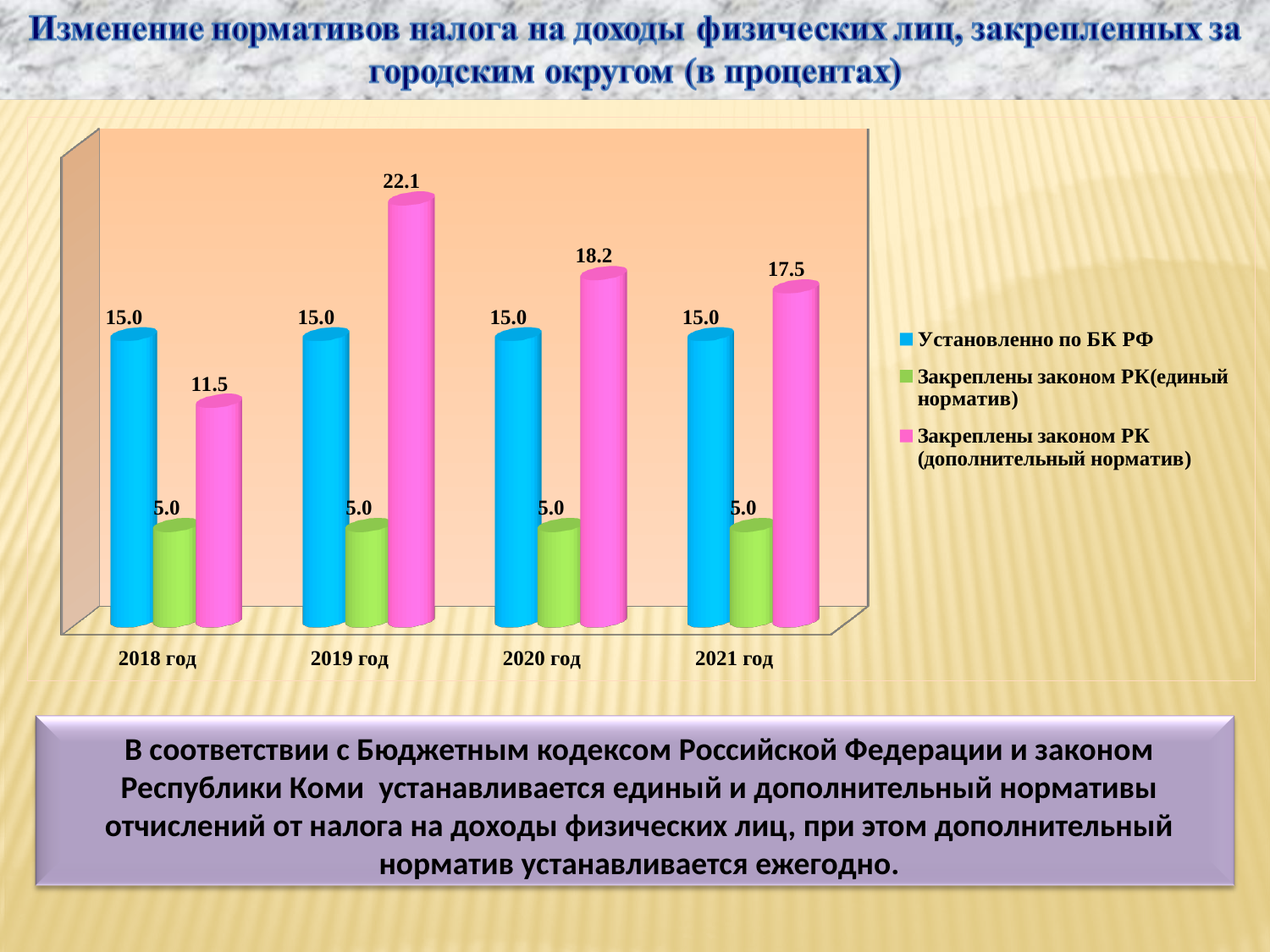
Which is larger in 2018 год: 'Установленно по БК РФ' or 'Закреплены законом РК (дополнительный норматив)'? Установленно по БК РФ What is the value for 'Закреплены законом РК(единый норматив)' in 2021 год? 5.0 What is the value for 'Закреплены законом РК (дополнительный норматив)' in 2018 год? 11.5 What is the difference between the 'дополнительный норматив' values for 2019 год and 2021 год? 4.6 What is the value for 'Установленно по БК РФ' in 2020 год? 15.0 In which year is the 'Закреплены законом РК (дополнительный норматив)' value highest? 2019 год How many series does the legend list? 3 In which year is the 'Закреплены законом РК (дополнительный норматив)' value lowest? 2018 год What kind of chart is shown on the slide? Bar chart What is the value for 'Закреплены законом РК (дополнительный норматив)' in 2019 год? 22.1 Which colour represents 'Закреплены законом РК(единый норматив)' in the legend? Green How many years are shown on the x axis? 4